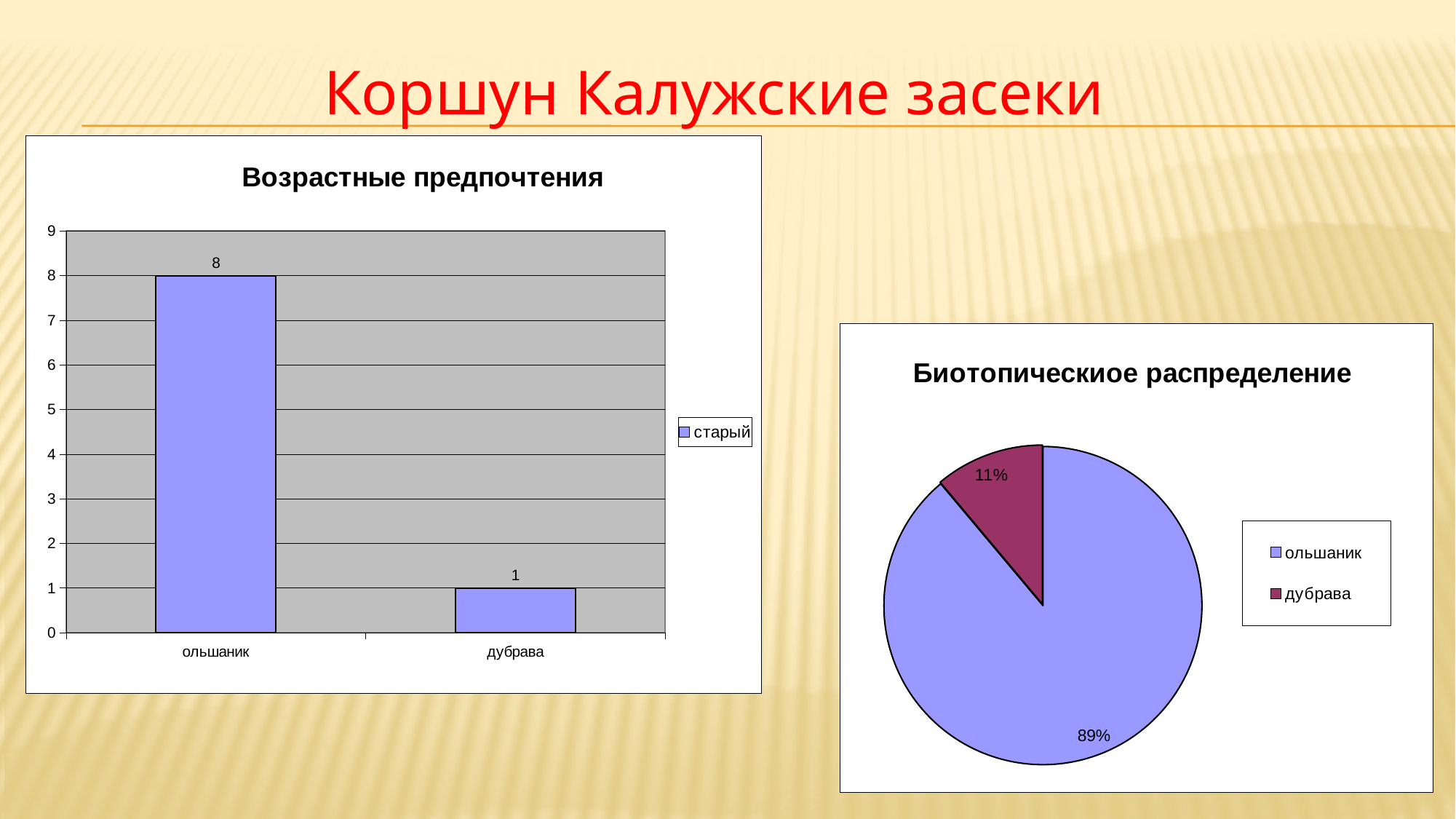
In the 'Возрастные предпочтения' chart, which category has the highest value? ольшаник In the 'Возрастные предпочтения' chart, what series name does the legend show? старый In the 'Возрастные предпочтения' chart, how many categories are shown on the x axis? 2 In the 'Возрастные предпочтения' chart, what kind of chart is it? bar chart In the 'Биотопическиое распределение' chart, what share does ольшаник have? 89% In the 'Возрастные предпочтения' chart, which category has the lowest value? дубрава In the 'Биотопическиое распределение' chart, what share does дубрава have? 11% In the 'Биотопическиое распределение' chart, what kind of chart is it? pie chart In the 'Возрастные предпочтения' chart, what is the difference between the values for ольшаник and дубрава? 7 In the 'Биотопическиое распределение' chart, which slice is larger, ольшаник or дубрава? ольшаник In the 'Возрастные предпочтения' chart, what is the value for ольшаник? 8 In the 'Возрастные предпочтения' chart, what is the value for дубрава? 1